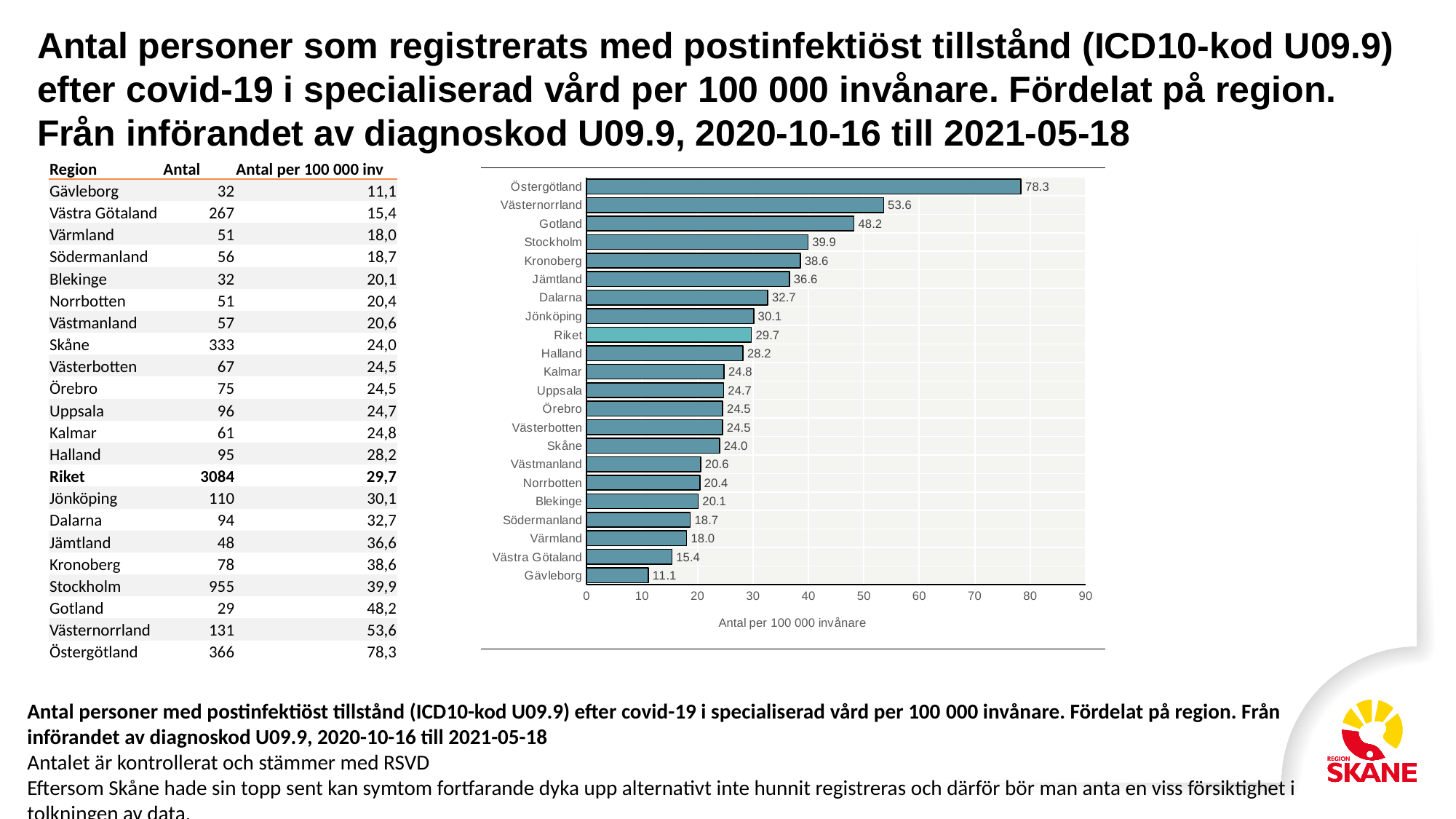
Is the value for Dalarna in the bar chart greater or less than 30? greater What is the difference between the values for Riket and Gävleborg in the bar chart? 18.6 What is the value for Östergötland in the bar chart? 78.3 Which has a larger value in the bar chart, Stockholm or Gotland? Gotland How many bars are shown in the bar chart? 22 Which region has the lowest value in the bar chart? Gävleborg What is the value for Skåne in the bar chart? 24.0 What is the difference between the values for Östergötland and Västernorrland in the bar chart? 24.7 What is the x-axis title of the bar chart? Antal per 100 000 invånare What type of chart is shown on the slide? Bar chart What is the value for Riket in the bar chart? 29.7 Which region has the highest value in the bar chart? Östergötland